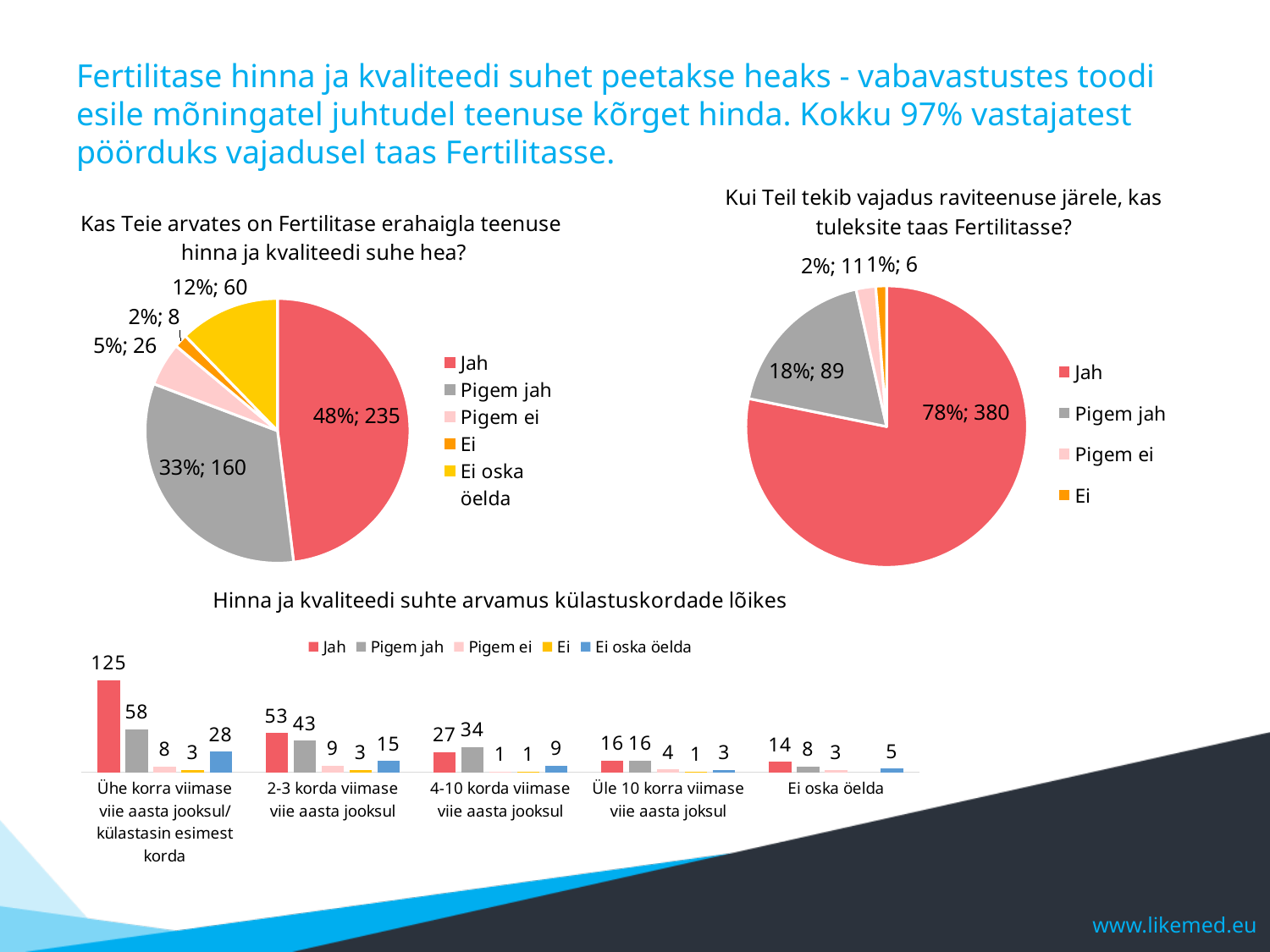
In the pie chart 'Kas Teie arvates on Fertilitase erahaigla teenuse hinna ja kvaliteedi suhe hea?', which category has the smallest slice? Ei In the bar chart 'Hinna ja kvaliteedi suhte arvamus külastuskordade lõikes', how many categories are shown on the x axis? 5 In the bar chart 'Hinna ja kvaliteedi suhte arvamus külastuskordade lõikes', how many series does the legend list? 5 In the pie chart 'Kui Teil tekib vajadus raviteenuse järele, kas tuleksite taas Fertilitasse?', what is the difference in count between 'Jah' and 'Pigem jah'? 291 In the pie chart 'Kui Teil tekib vajadus raviteenuse järele, kas tuleksite taas Fertilitasse?', which category has the largest slice? Jah In the bar chart 'Hinna ja kvaliteedi suhte arvamus külastuskordade lõikes', what is the value of 'Jah' for '2-3 korda viimase viie aasta jooksul'? 53 What kind of chart is 'Hinna ja kvaliteedi suhte arvamus külastuskordade lõikes'? Bar chart In the pie chart 'Kas Teie arvates on Fertilitase erahaigla teenuse hinna ja kvaliteedi suhe hea?', how many categories does the legend list? 5 In the bar chart 'Hinna ja kvaliteedi suhte arvamus külastuskordade lõikes', which is larger for '4-10 korda viimase viie aasta jooksul': 'Jah' or 'Pigem jah'? Pigem jah In the pie chart 'Kui Teil tekib vajadus raviteenuse järele, kas tuleksite taas Fertilitasse?', what share and count does 'Pigem jah' have? 18%; 89 In the bar chart 'Hinna ja kvaliteedi suhte arvamus külastuskordade lõikes', what is the difference between 'Jah' and 'Pigem jah' for 'Ühe korra viimase viie aasta jooksul/ külastasin esimest korda'? 67 In the pie chart 'Kas Teie arvates on Fertilitase erahaigla teenuse hinna ja kvaliteedi suhe hea?', what share and count does 'Jah' have? 48%; 235